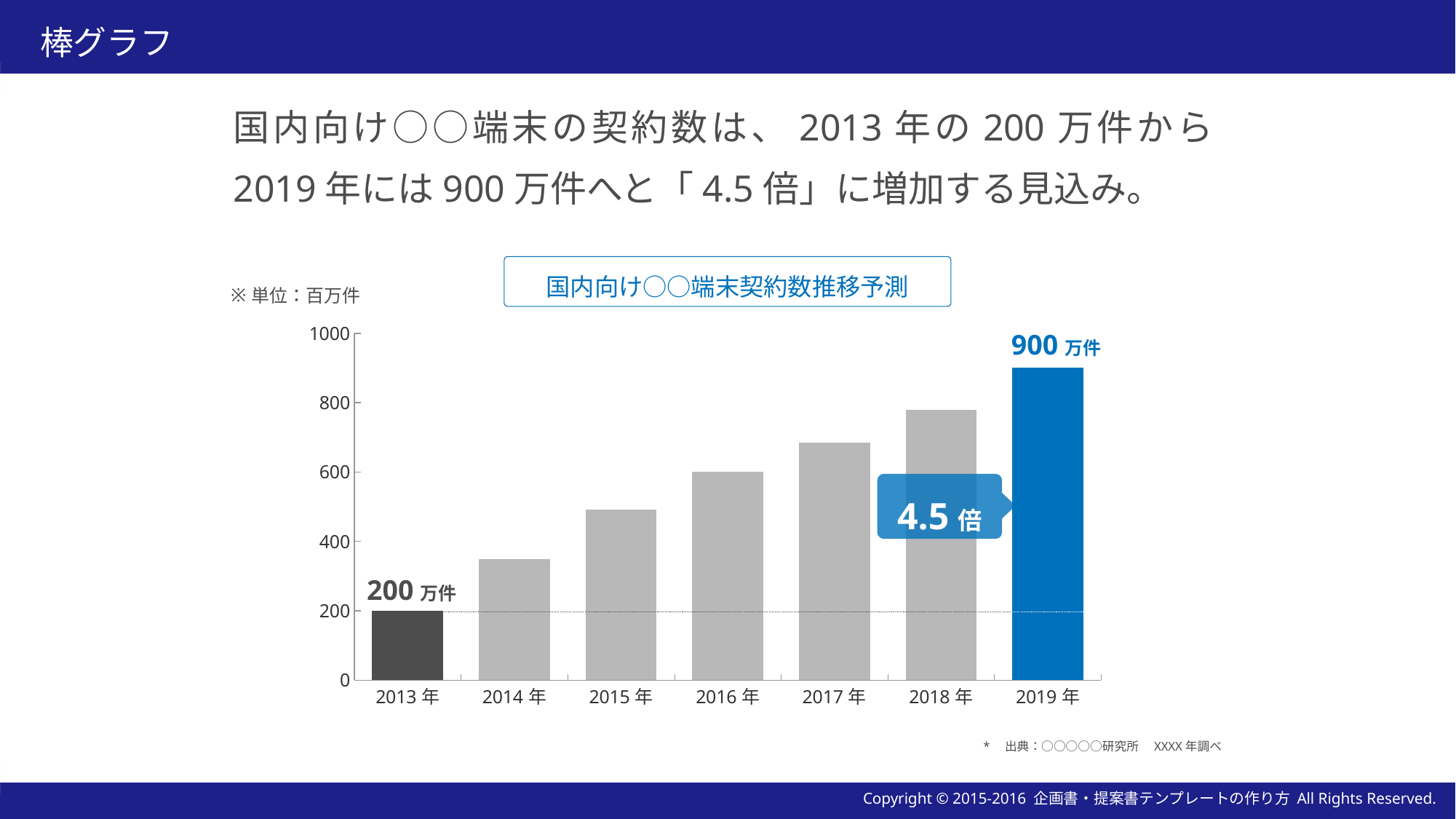
What kind of chart is shown on the slide? bar chart What is the value for 2013年? 200万件 Which year has the highest value? 2019年 Do the values rise or fall from 2013年 to 2019年? rise What is the difference between the values for 2019年 and 2013年? 700万件 Which year has the lowest value? 2013年 Is the value for 2015年 greater or less than 400? greater How many years are shown on the x axis? 7 Which is larger, the value for 2018年 or the value for 2016年? 2018年 What is the value for 2019年? 900万件 Is the value for 2017年 greater or less than 600? greater Is the value for 2014年 greater or less than 400? less